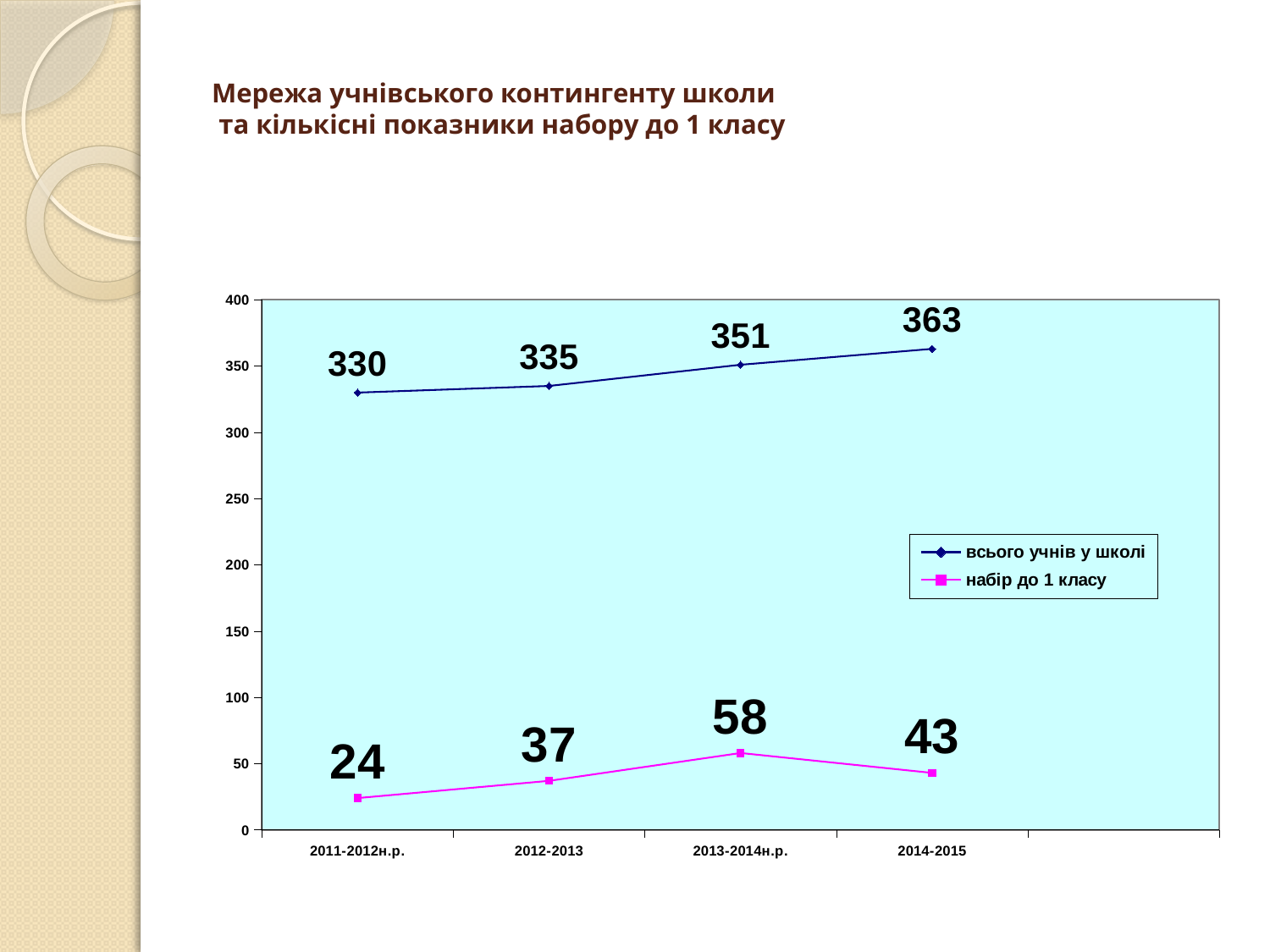
How many series does the legend list? 2 How many years are plotted on the x axis? 4 What is the value for 'всього учнів у школі' in 2014-2015? 363 What is the difference between 'всього учнів у школі' in 2014-2015 and in 2011-2012н.р.? 33 What type of chart is shown on the slide? line chart What is the value for 'набір до 1 класу' in 2013-2014н.р.? 58 In which year is 'набір до 1 класу' highest? 2013-2014н.р. What colour is the line for 'набір до 1 класу'? magenta In which year is 'всього учнів у школі' lowest? 2011-2012н.р. Which is larger: 'набір до 1 класу' in 2012-2013 or in 2014-2015? 2014-2015 What is the value for 'всього учнів у школі' in 2011-2012н.р.? 330 Does 'всього учнів у школі' rise or fall from 2011-2012н.р. to 2014-2015? rise